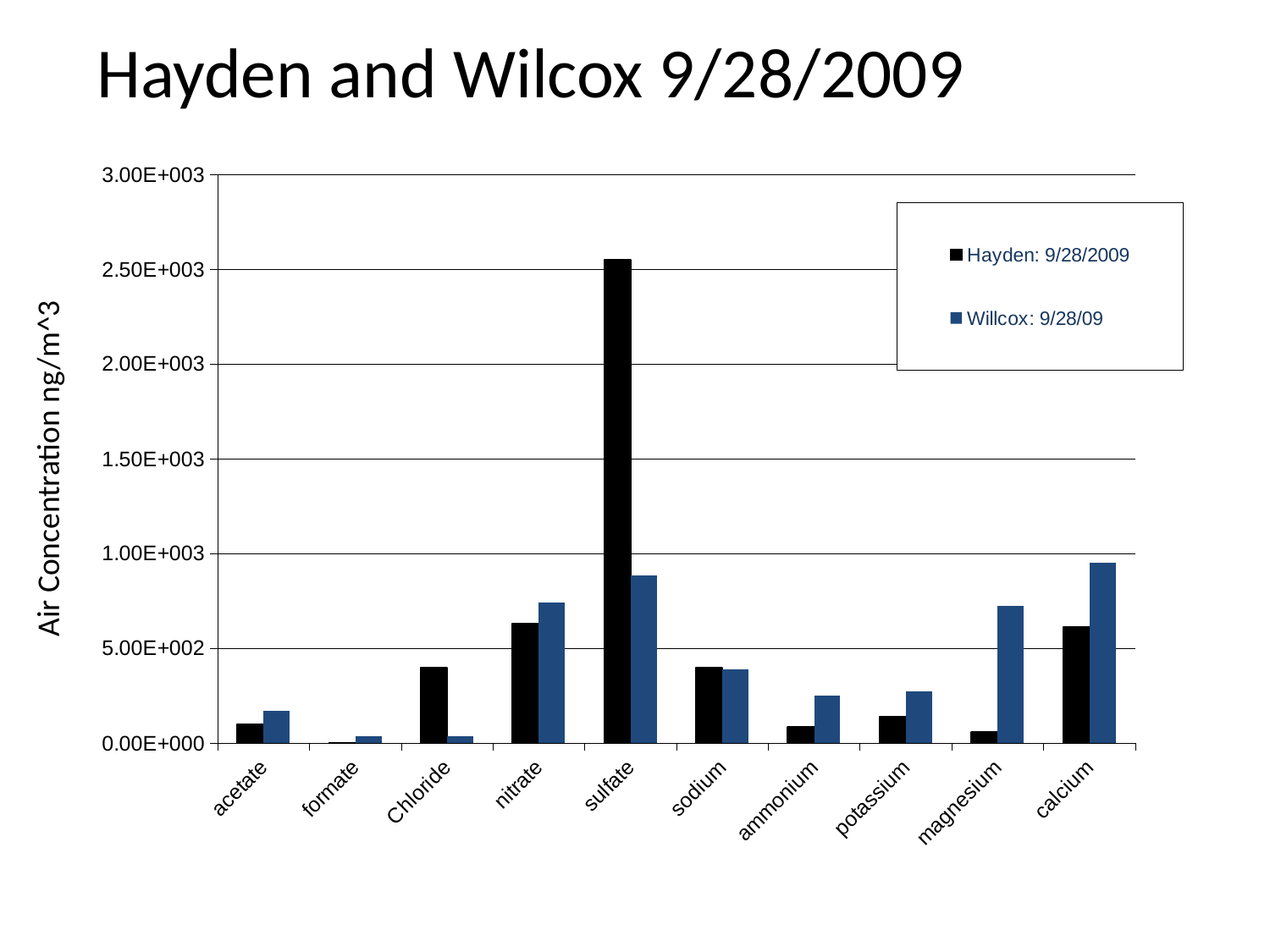
For which category is the Willcox: 9/28/09 value highest? calcium What is the label of the y axis? Air Concentration ng/m^3 Is the Willcox: 9/28/09 value for sulfate greater or less than 1.00E+003? less For which category is the Hayden: 9/28/2009 value lowest? formate How many series does the legend list? 2 For sulfate, which series has the larger value, Hayden: 9/28/2009 or Willcox: 9/28/09? Hayden: 9/28/2009 How many categories are shown on the x axis? 10 What kind of chart is shown on the slide? bar chart For which category is the Hayden: 9/28/2009 value highest? sulfate For Chloride, which series has the larger value, Hayden: 9/28/2009 or Willcox: 9/28/09? Hayden: 9/28/2009 Is the Hayden: 9/28/2009 value for sulfate greater or less than 2.00E+003? greater For magnesium, which series has the larger value, Hayden: 9/28/2009 or Willcox: 9/28/09? Willcox: 9/28/09